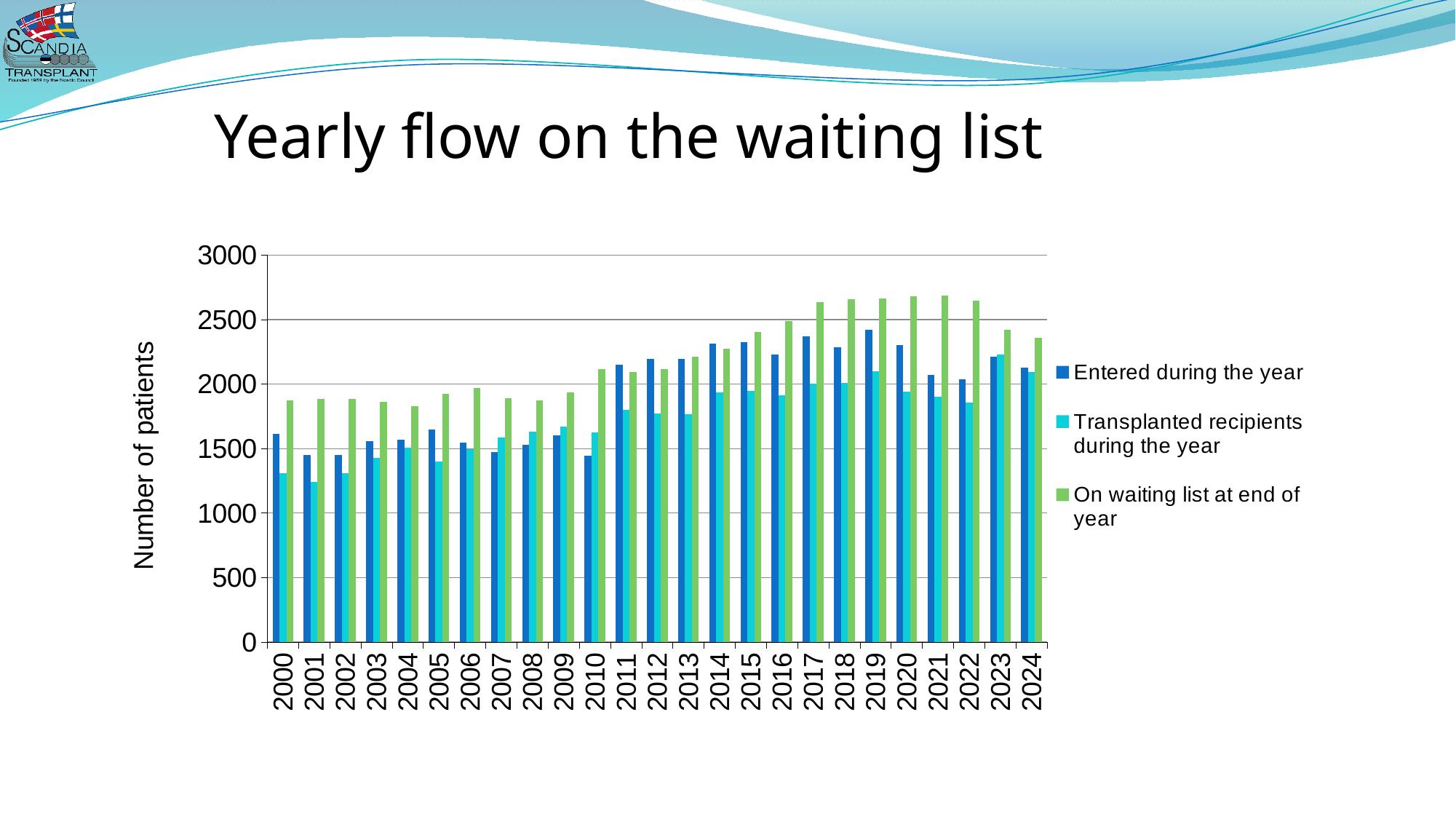
How many years are shown on the x axis? 25 Which series is shown in green? On waiting list at end of year How many series does the legend list? 3 Is the value for 'On waiting list at end of year' in 2021 greater or less than 2500? greater Is the value for 'Entered during the year' in 2019 greater or less than 2000? greater Is the value for 'Transplanted recipients during the year' in 2000 greater or less than 1500? less In which year is the value for 'Transplanted recipients during the year' highest? 2023 What is the label of the y axis? Number of patients What kind of chart is shown on the slide? Bar chart In 2011, which is larger: 'Entered during the year' or 'Transplanted recipients during the year'? Entered during the year In which year is the value for 'Transplanted recipients during the year' lowest? 2001